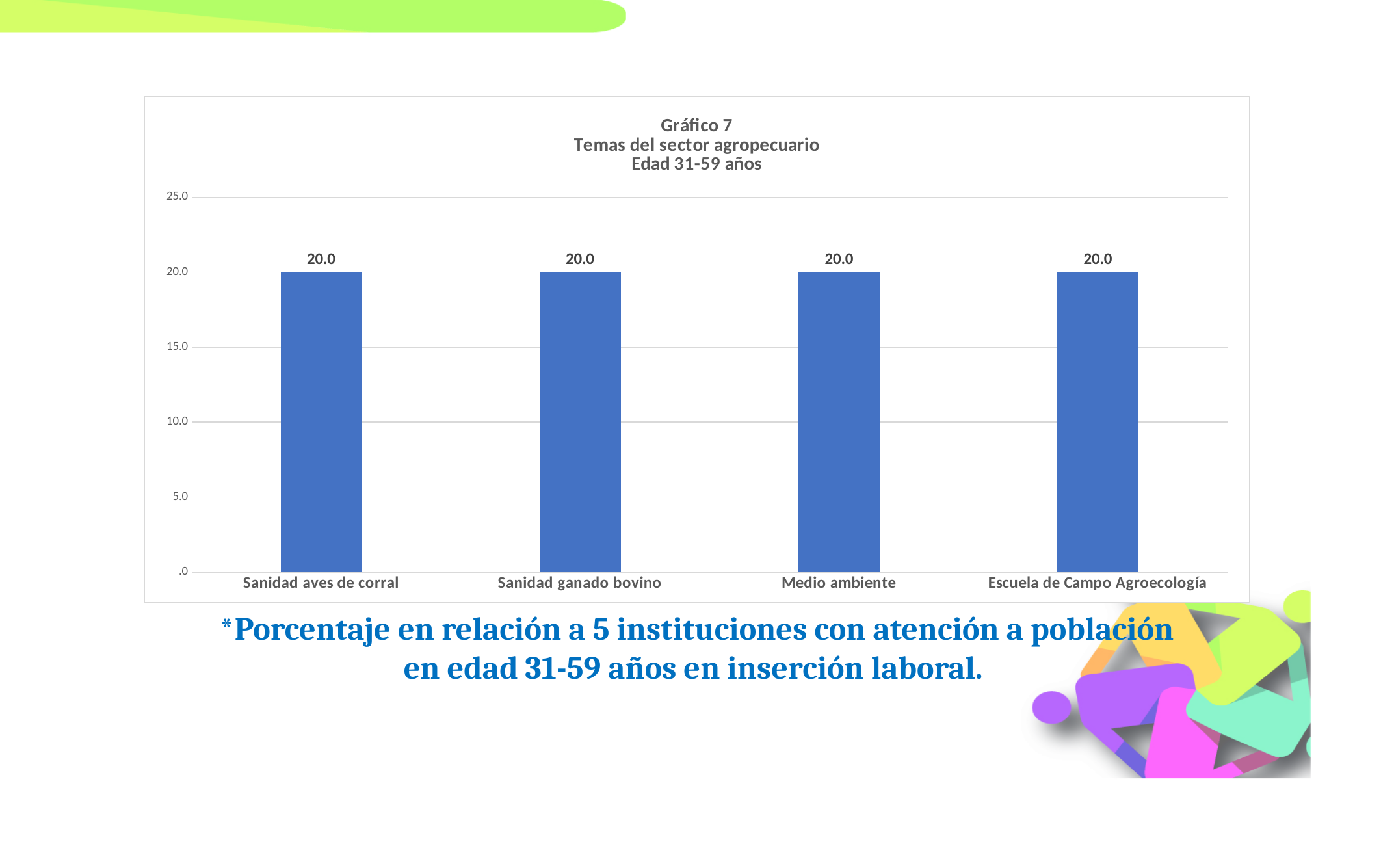
Is the value for Sanidad ganado bovino greater or less than 15.0? greater What is the title of the chart? Gráfico 7 Temas del sector agropecuario Edad 31-59 años How many categories are shown on the x axis? 4 Do the values rise, fall or stay the same across the categories from left to right? Stay the same What is the value for Sanidad aves de corral? 20.0 What is the value for Medio ambiente? 20.0 What kind of chart is shown on the slide? Bar chart What colour are the bars in the chart? Blue What is the difference between the values for Medio ambiente and Sanidad aves de corral? 0.0 What is the value for Escuela de Campo Agroecología? 20.0 Is the value for Escuela de Campo Agroecología greater or less than 25.0? less What is the value for Sanidad ganado bovino? 20.0